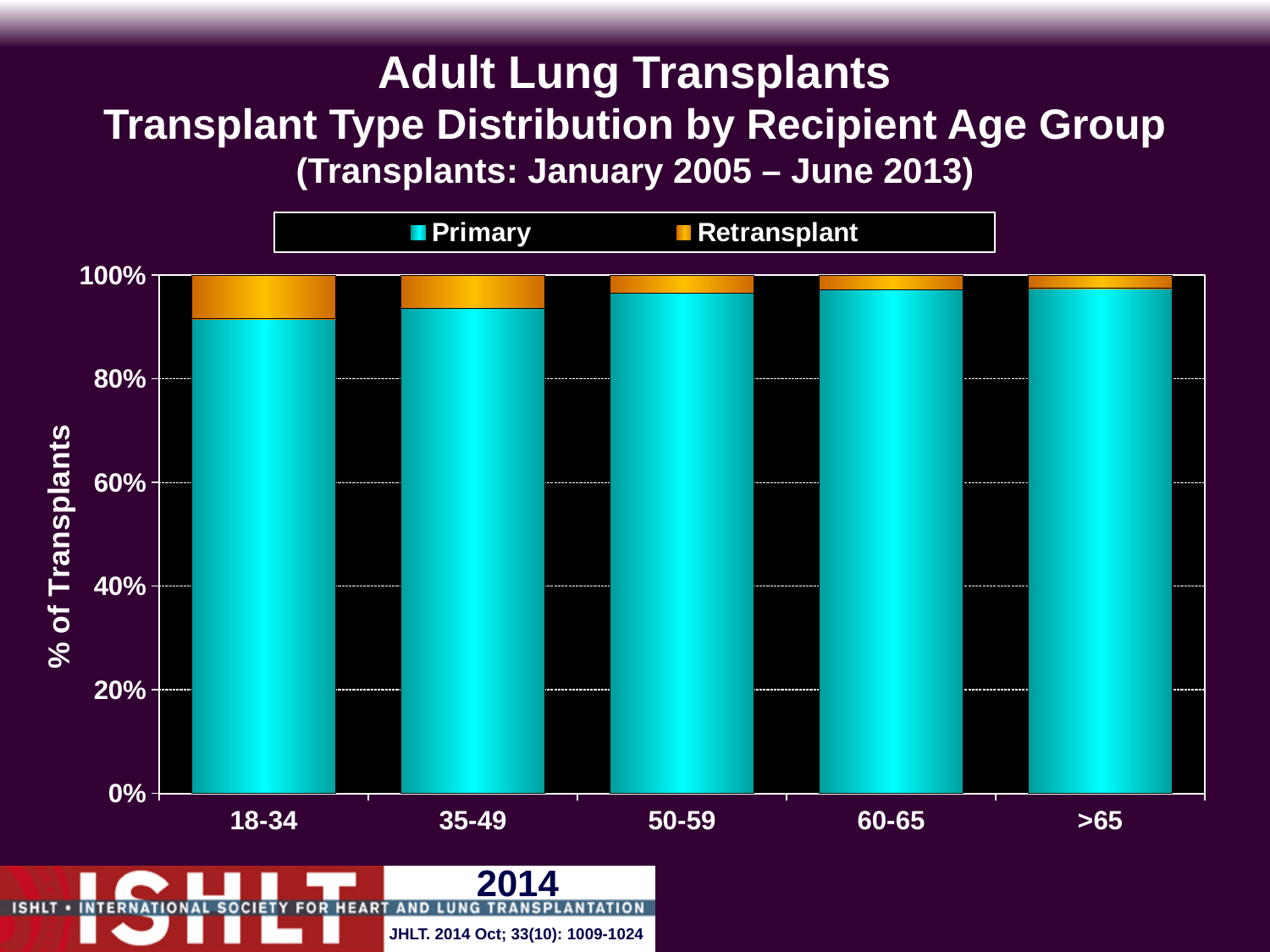
Does the Retransplant share generally rise or fall as recipient age increases along the x axis? fall How many recipient age groups are shown on the x axis? 5 Is the Primary value for the 18-34 age group greater or less than 80%? greater What is the total height of each stacked bar? 100% Which is larger, the Retransplant share for 18-34 or for 50-59? 18-34 What kind of chart is shown on the slide? stacked bar chart What are the two series named in the legend? Primary and Retransplant How many series does the legend list? 2 Is the Retransplant value for the 18-34 age group greater or less than 20%? less What is the label of the y axis? % of Transplants Which age group has the largest Retransplant share? 18-34 Which age group has the smallest Primary share? 18-34